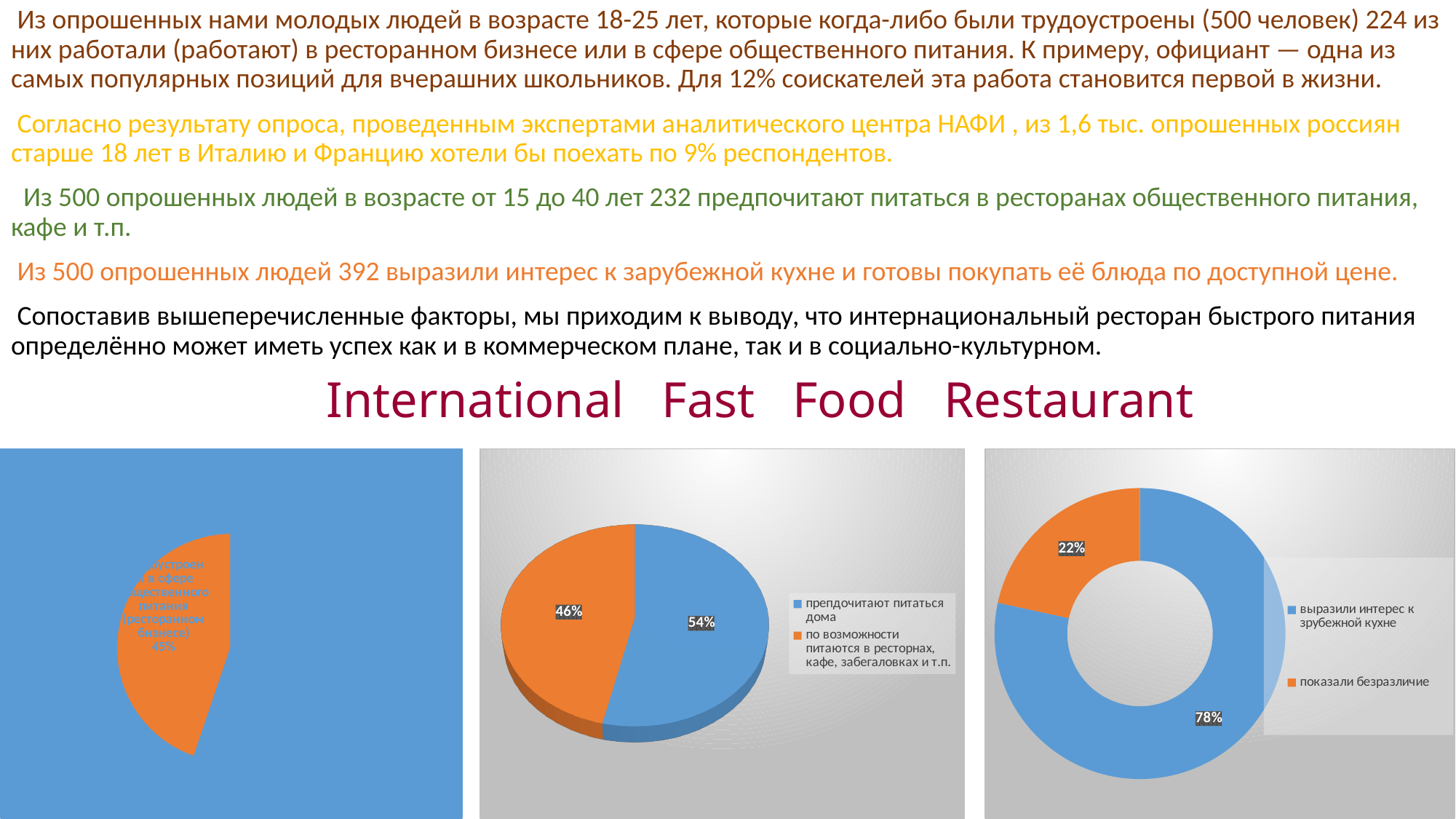
What kind of chart is the right chart? doughnut chart In the right chart, what percentage is shown for 'показали безразличие'? 22% How many entries does the legend of the middle chart list? 2 In the right chart, what percentage is shown for 'выразили интерес к зрубежной кухне'? 78% In the middle chart, what percentage is shown for 'препдочитают питаться дома'? 54% In the left chart, what percentage is printed on the orange slice? 45% What kind of chart is the middle chart? pie chart In the right chart, what is the difference in percentage points between 'выразили интерес к зрубежной кухне' and 'показали безразличие'? 56% In the middle chart, what is the difference in percentage points between the two slices? 8% In the middle chart, which category has the larger share? препдочитают питаться дома In the right chart, which category has the smallest share? показали безразличие In the middle chart, what percentage is shown for 'по возможности питаются в ресторнах, кафе, забегаловках и т.п.'? 46%